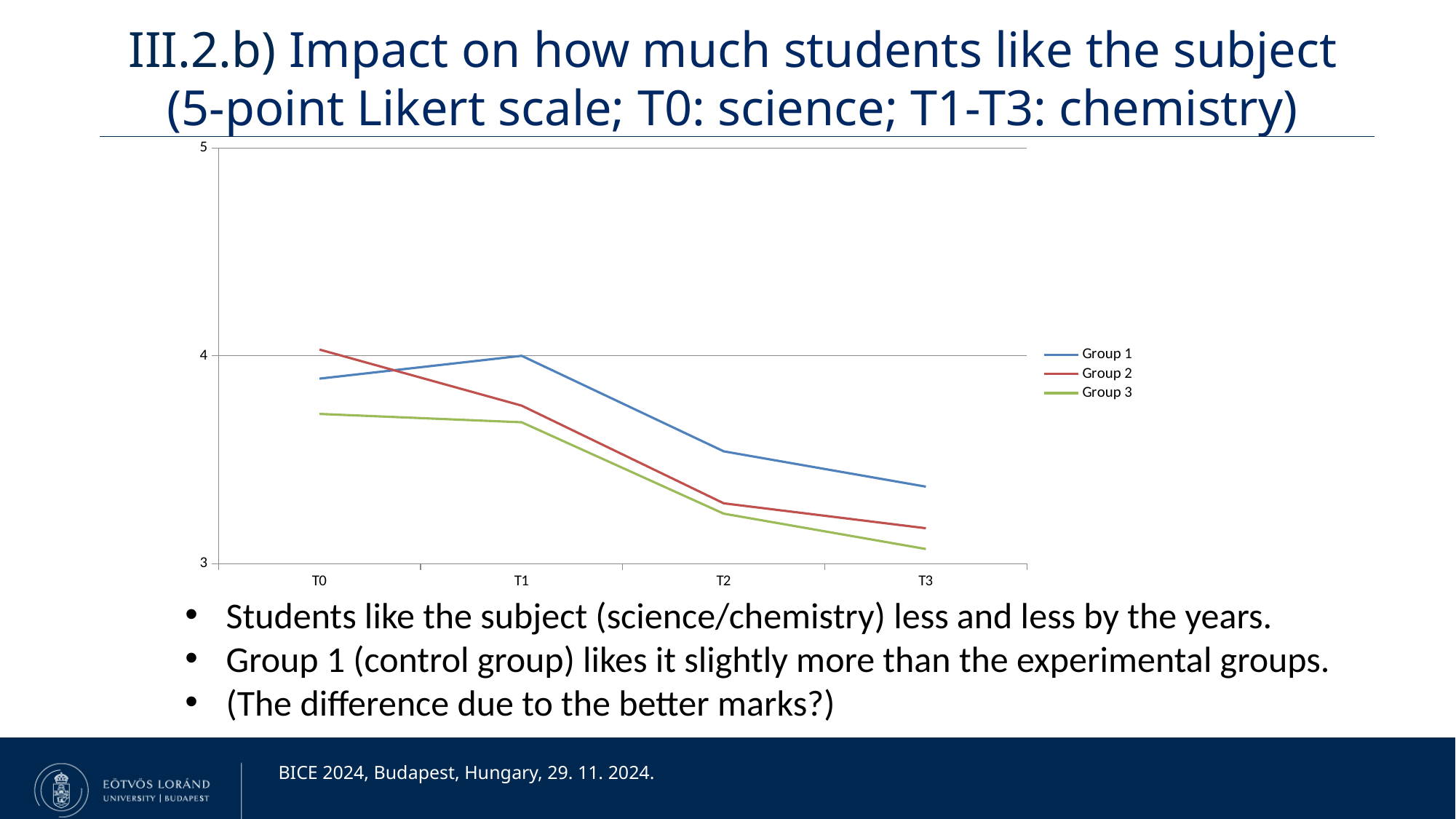
At T1, which is larger: the value for Group 1 or the value for Group 3? Group 1 Is the value for Group 3 at T0 greater or less than 4? less Does the value for Group 3 rise or fall from T1 to T3? fall Which group has the highest value at T0? Group 2 What kind of chart is shown on the slide? line chart Is the value for Group 1 at T2 greater or less than 4? less How many time points are shown on the x axis? 4 How many series does the legend list? 3 Does the value for Group 2 rise or fall from T0 to T3? fall Which group has the highest value at T3? Group 1 What colour is the line for Group 1? blue Which group has the lowest value at T3? Group 3